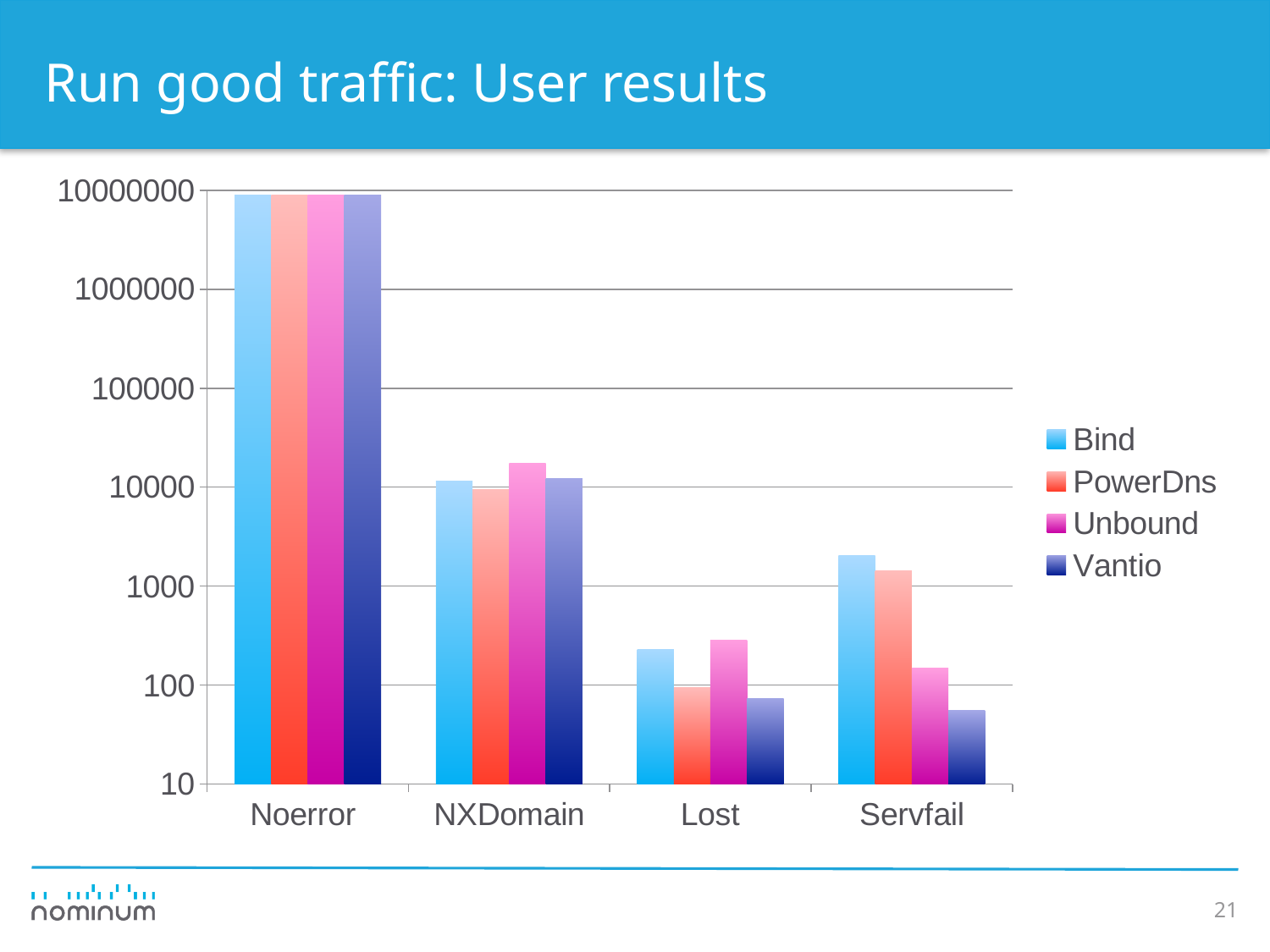
Which series is shown in the darkest blue colour in the legend? Vantio Is the value for Unbound in the NXDomain category greater or less than 10000? greater Is the value for Vantio in the Lost category greater or less than 100? less Is the value for Bind in the Servfail category greater or less than 1000? greater In the Lost category, which is larger: the value for Unbound or the value for Vantio? Unbound Which series has the highest value in the Servfail category? Bind How many series does the legend list? 4 What kind of chart is shown on the slide? bar chart How many categories are shown on the x axis? 4 What is the title of the slide containing the chart? Run good traffic: User results Which series has the lowest value in the Lost category? Vantio